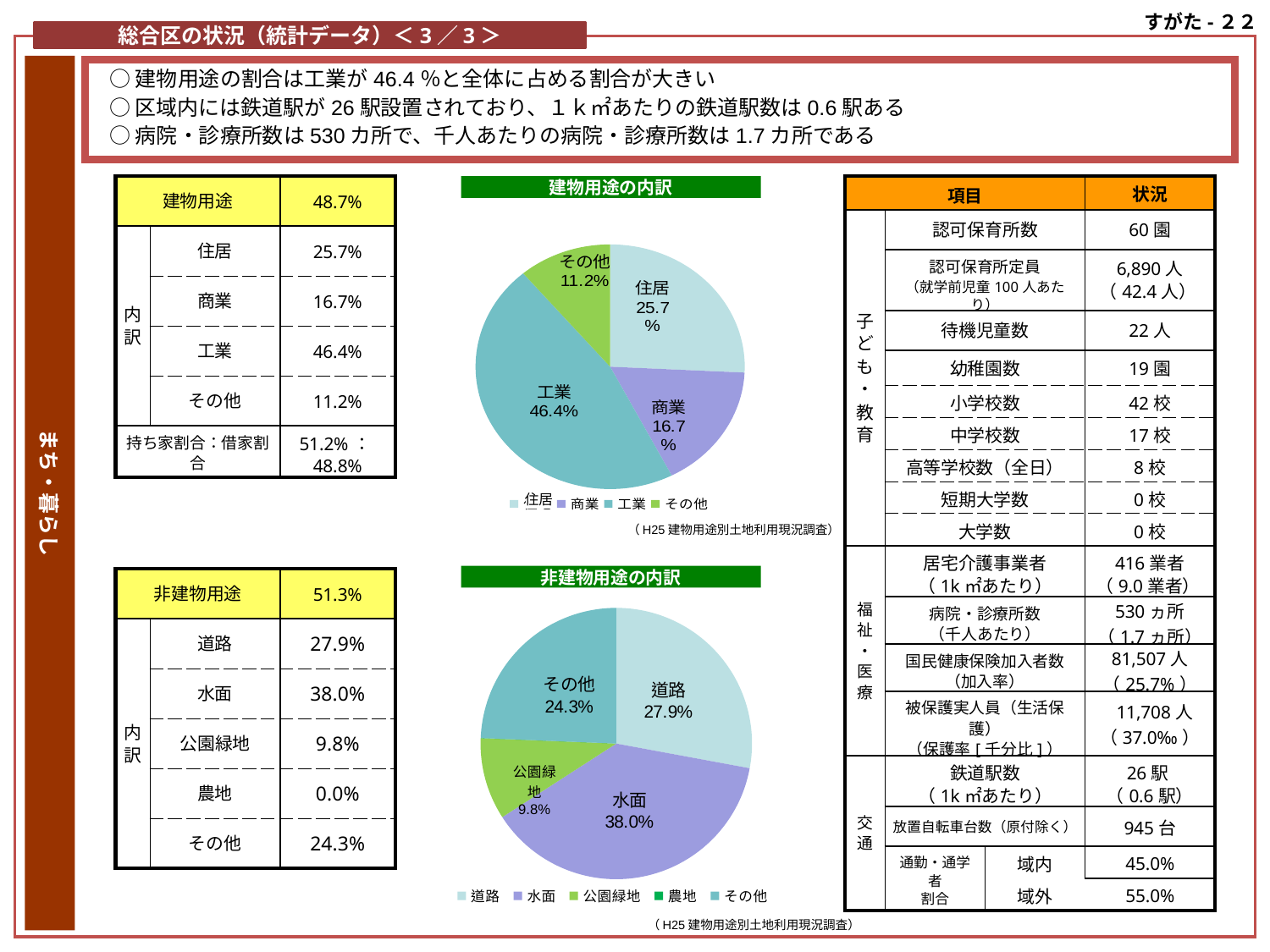
In the 建物用途の内訳 chart, what is the value for 商業? 16.7% In the 建物用途の内訳 chart, which category has the smallest share? その他 In the 非建物用途の内訳 chart, what is the difference between 水面 and 道路? 10.1% In the 建物用途の内訳 chart, what is the value for 工業? 46.4% In the 建物用途の内訳 chart, which category has the largest share? 工業 In the 建物用途の内訳 chart, how many entries does the legend list? 4 In the 非建物用途の内訳 chart, which is larger, 道路 or その他? 道路 In the 建物用途の内訳 chart, what is the difference between 住居 and 商業? 9.0% In the 非建物用途の内訳 chart, what is the value for 水面? 38.0% In the 非建物用途の内訳 chart, what is the value for 公園緑地? 9.8% What kind of chart is the 非建物用途の内訳 chart? Pie chart In the 非建物用途の内訳 chart, how many entries does the legend list? 5